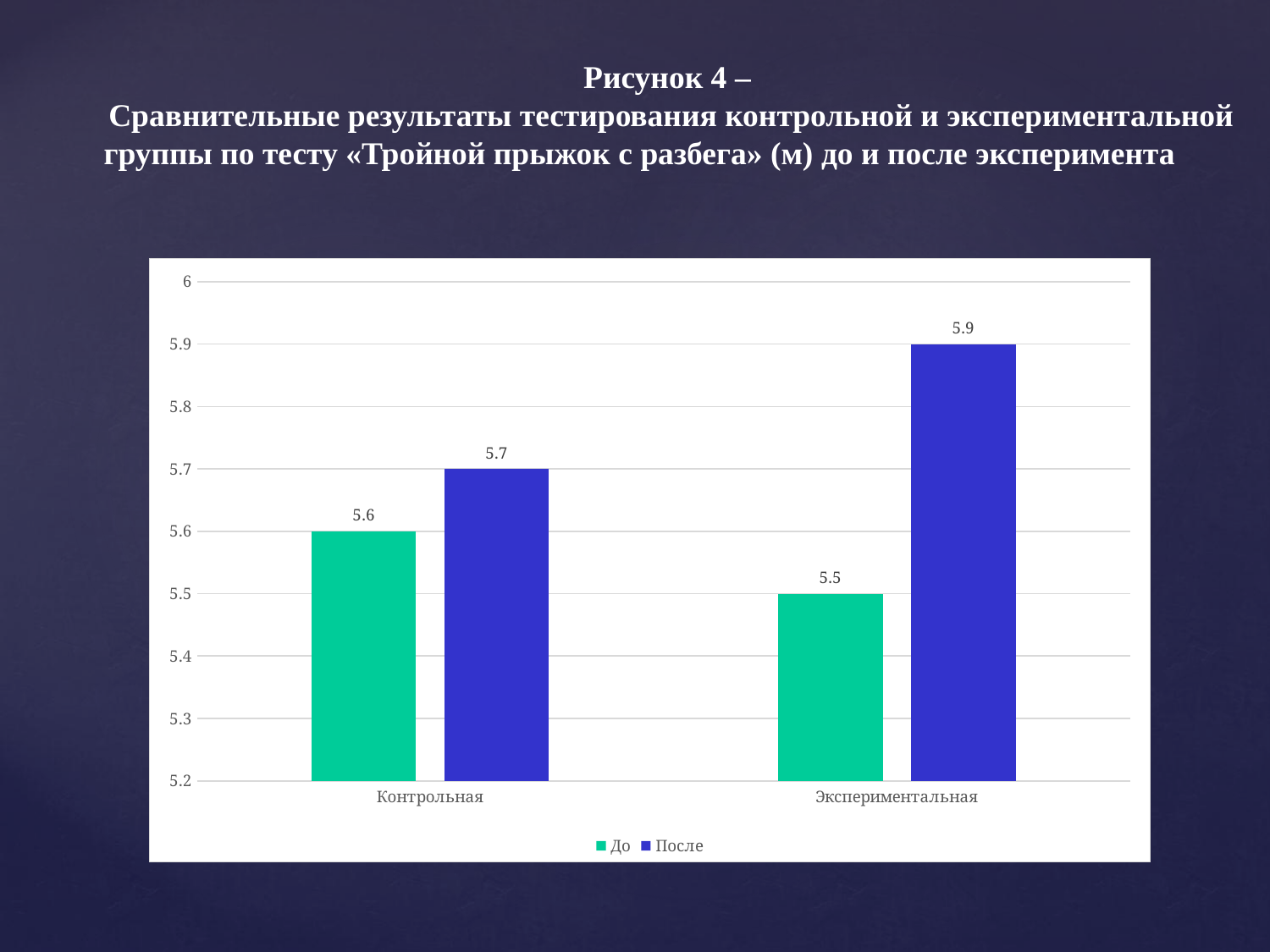
What is the value for the Экспериментальная group in the До series? 5.5 Which group has the lowest value in the До series? Экспериментальная Which group has the highest value in the После series? Экспериментальная Is the После value for the Экспериментальная group greater or less than 5.8? greater Which is larger: the До value for Контрольная or the До value for Экспериментальная? Контрольная What is the value for the Контрольная group in the После series? 5.7 How many groups are shown on the x axis? 2 What is the difference between the После and До values for the Экспериментальная group? 0.4 What kind of chart is shown on the slide? bar chart What is the value for the Контрольная group in the До series? 5.6 How many series does the legend list? 2 What is the value for the Экспериментальная group in the После series? 5.9